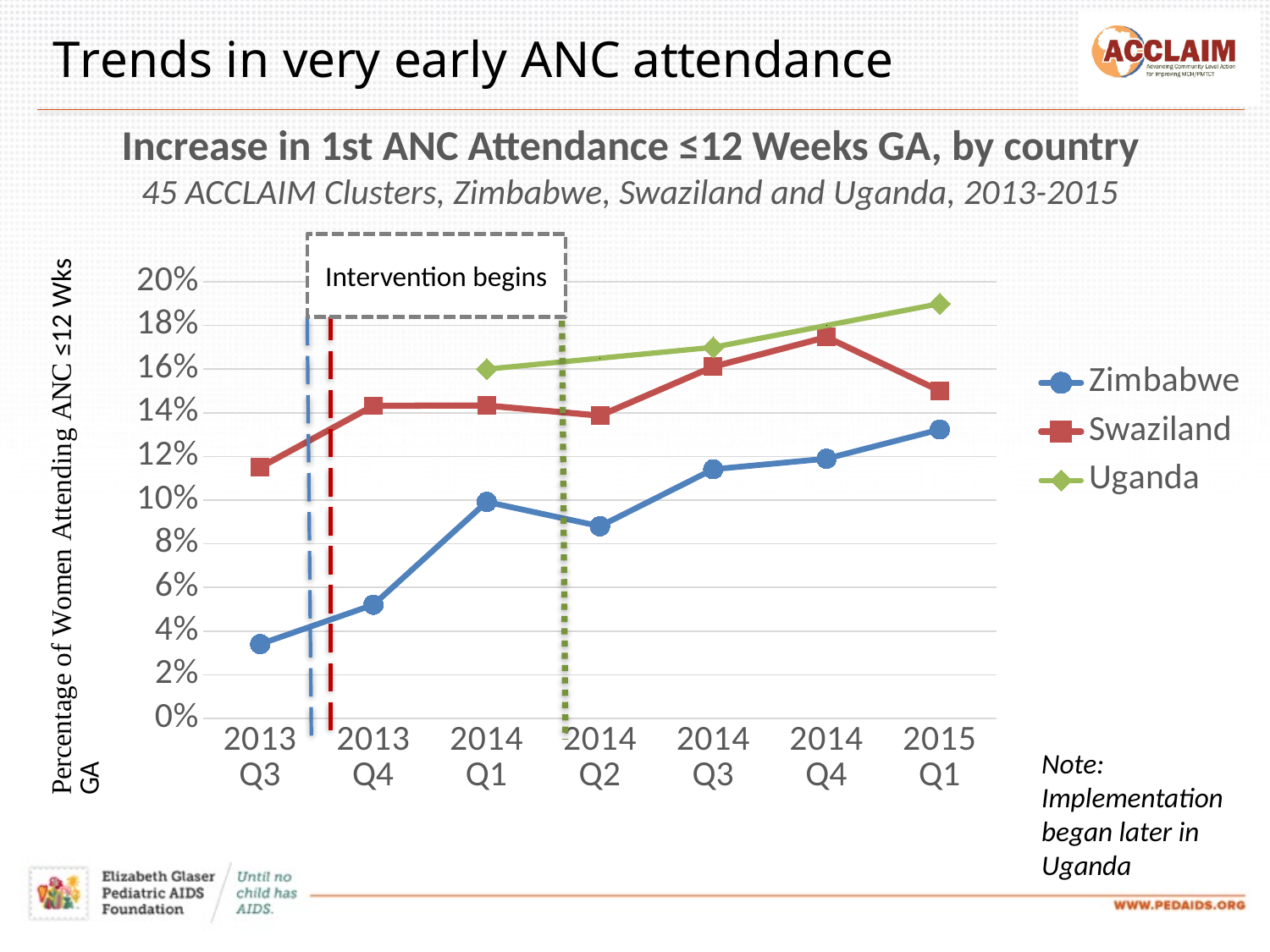
In 2014 Q3, which is larger, the value for Swaziland or the value for Zimbabwe? Swaziland How many series does the legend list? 3 Is the value for Zimbabwe in 2013 Q3 greater or less than 4%? less What does the dashed box annotation on the chart say? Intervention begins Is the value for Uganda in 2015 Q1 greater or less than 18%? greater Which country has the lowest value in 2013 Q3? Zimbabwe What kind of chart is shown on the slide? line chart Which country has the highest value in 2015 Q1? Uganda Does the Zimbabwe line generally rise or fall from 2013 Q3 to 2015 Q1? rise How many quarters are shown along the x axis? 7 Is the value for Zimbabwe in 2015 Q1 greater or less than 12%? greater